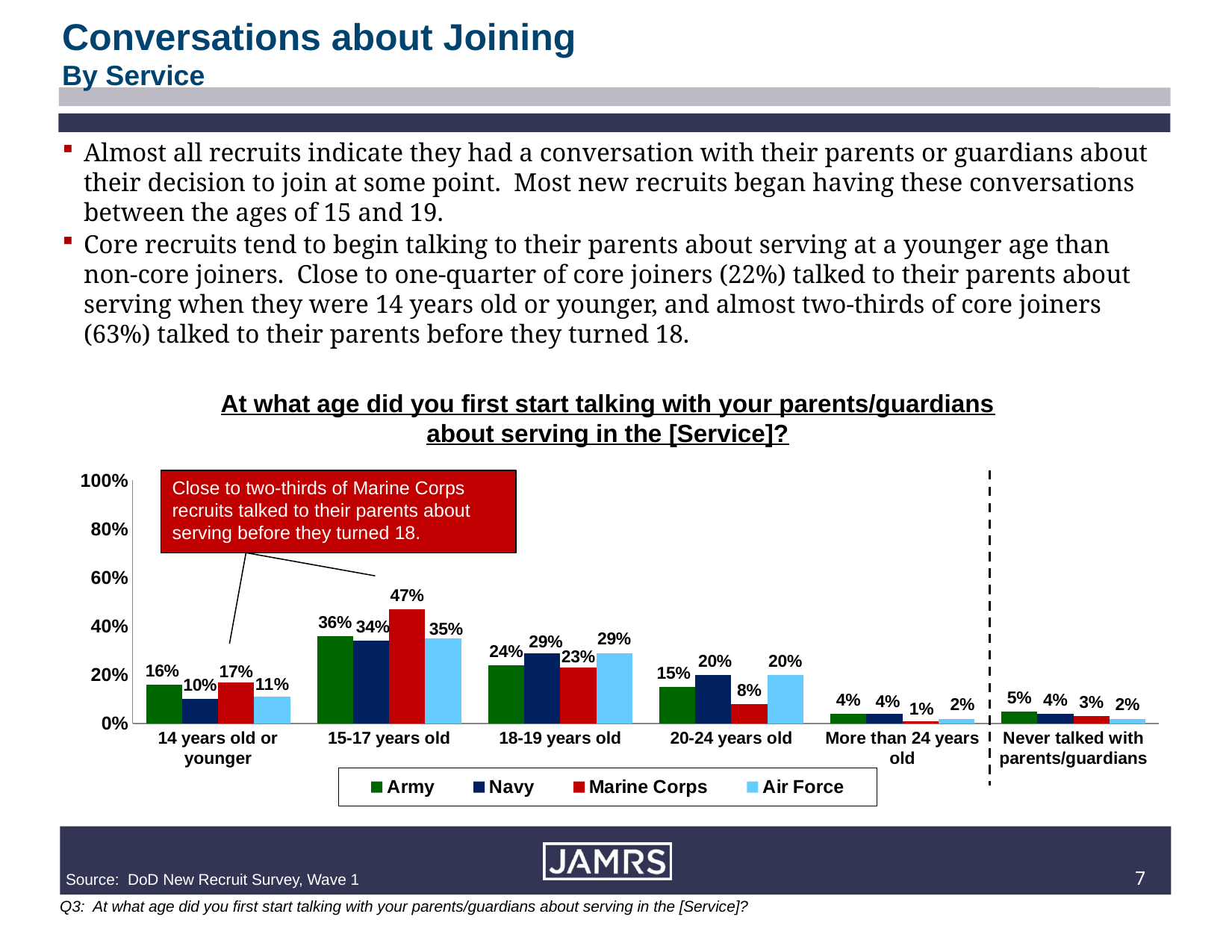
How many series does the legend list? 4 What is the difference between the Marine Corps and Army values for 15-17 years old? 11% For Army, do the values rise or fall from 15-17 years old through More than 24 years old? Fall Which series is shown in red in the legend? Marine Corps Which is larger in the 18-19 years old category: Army or Navy? Navy How many age/response categories are shown on the x axis? 6 Which service has the highest value in the 15-17 years old category? Marine Corps What is the value for Navy in the 14 years old or younger category? 10% Which service has the lowest value in the 20-24 years old category? Marine Corps What kind of chart is shown on the slide? Bar chart What percentage of Air Force recruits never talked with parents/guardians? 2% What percentage of Marine Corps recruits first started talking with their parents/guardians at 15-17 years old? 47%